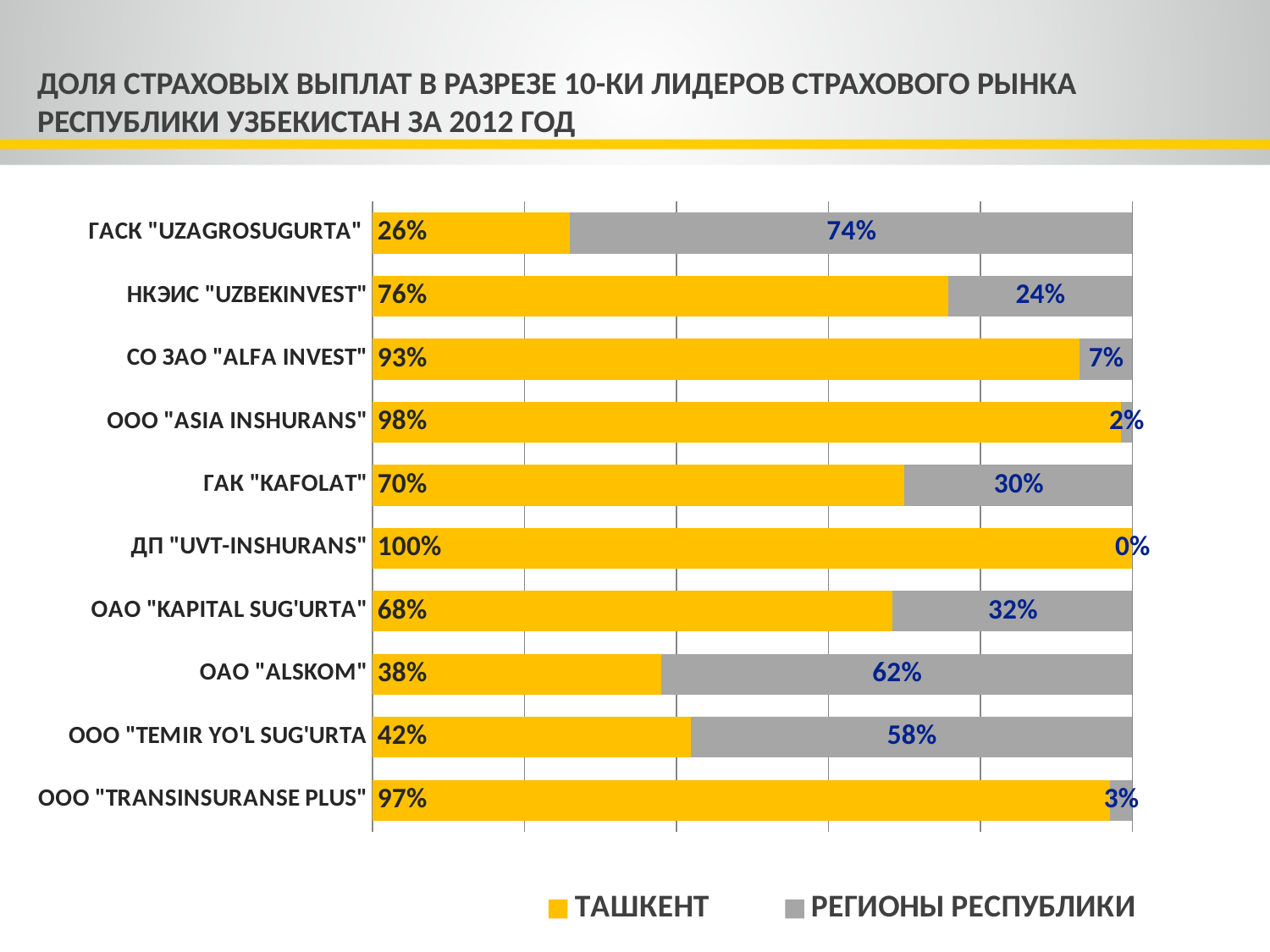
Which company has the lowest ТАШКЕНТ share? ГАСК "UZAGROSUGURTA" What is the difference between the РЕГИОНЫ РЕСПУБЛИКИ shares of ГАСК "UZAGROSUGURTA" and НКЭИС "UZBEKINVEST"? 50% What is the РЕГИОНЫ РЕСПУБЛИКИ share for ОАО "ALSKOM"? 62% How many series does the legend list? 2 What kind of chart is shown on the slide? Stacked bar chart Which colour represents ТАШКЕНТ in the chart? Yellow How many companies are shown in the chart? 10 Which company has the highest ТАШКЕНТ share? ДП "UVT-INSHURANS" What is the ТАШКЕНТ share for ГАСК "UZAGROSUGURTA"? 26% What is the total of the stacked bar for СО ЗАО "ALFA INVEST"? 100% Which is larger: the ТАШКЕНТ share for ОАО "ALSKOM" or for ООО "TEMIR YO'L SUG'URTA"? ООО "TEMIR YO'L SUG'URTA" What is the ТАШКЕНТ share for ГАК "KAFOLAT"? 70%